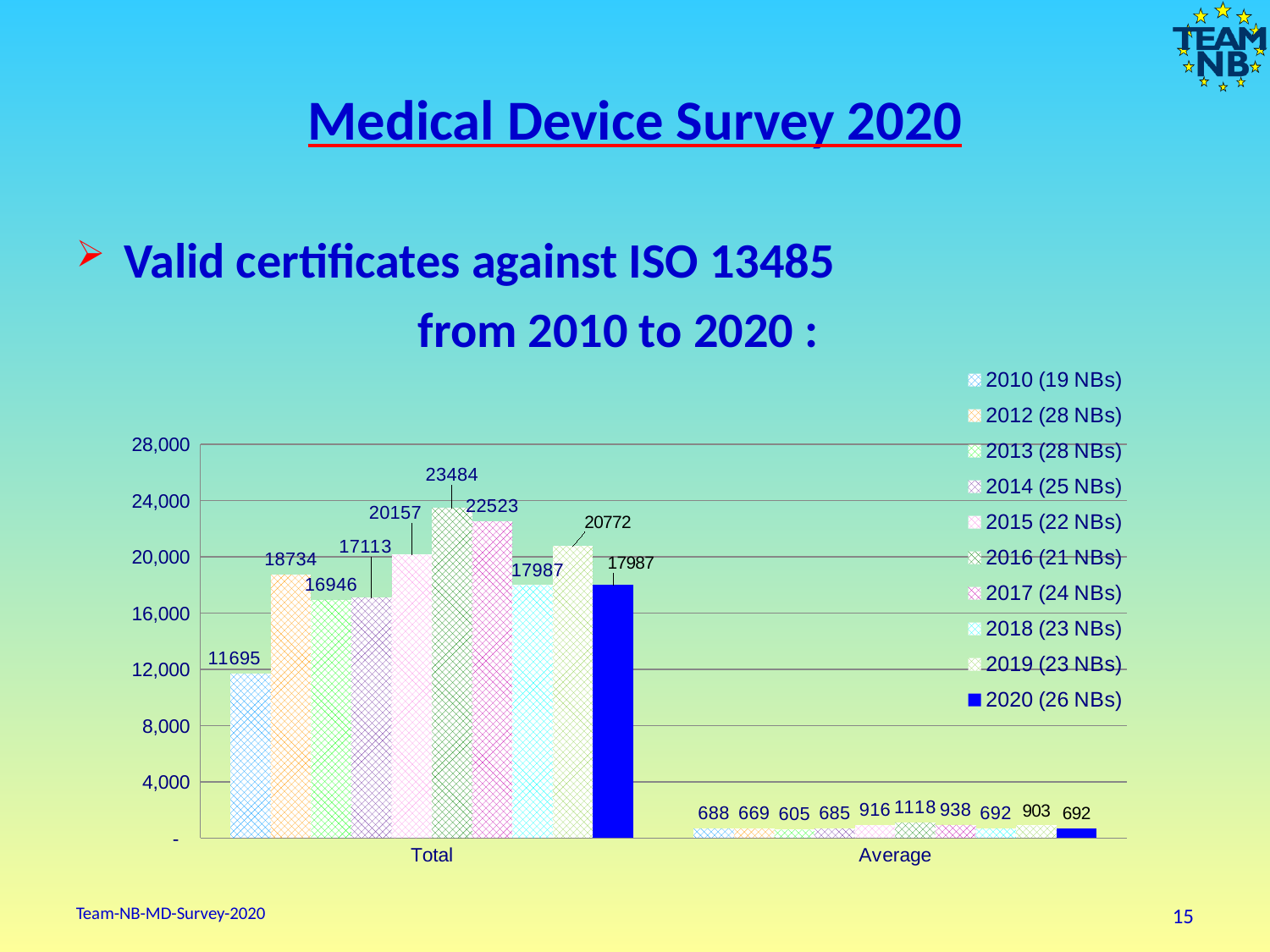
What is the Total value for 2020 (26 NBs)? 17987 What is the Average value for 2016 (21 NBs)? 1118 Is the Total value for 2012 (28 NBs) greater or less than 16,000? greater Which series has the highest Total value? 2016 (21 NBs) Which series has the lowest Average value? 2013 (28 NBs) How many categories are shown on the x axis? 2 How many series does the legend list? 10 Which is larger, the Total value for 2015 (22 NBs) or for 2019 (23 NBs)? 2019 (23 NBs) What is the Average value for 2019 (23 NBs)? 903 What is the Total value for 2010 (19 NBs)? 11695 What kind of chart is shown on the slide? bar chart What is the difference between the Total values for 2016 (21 NBs) and 2010 (19 NBs)? 11789